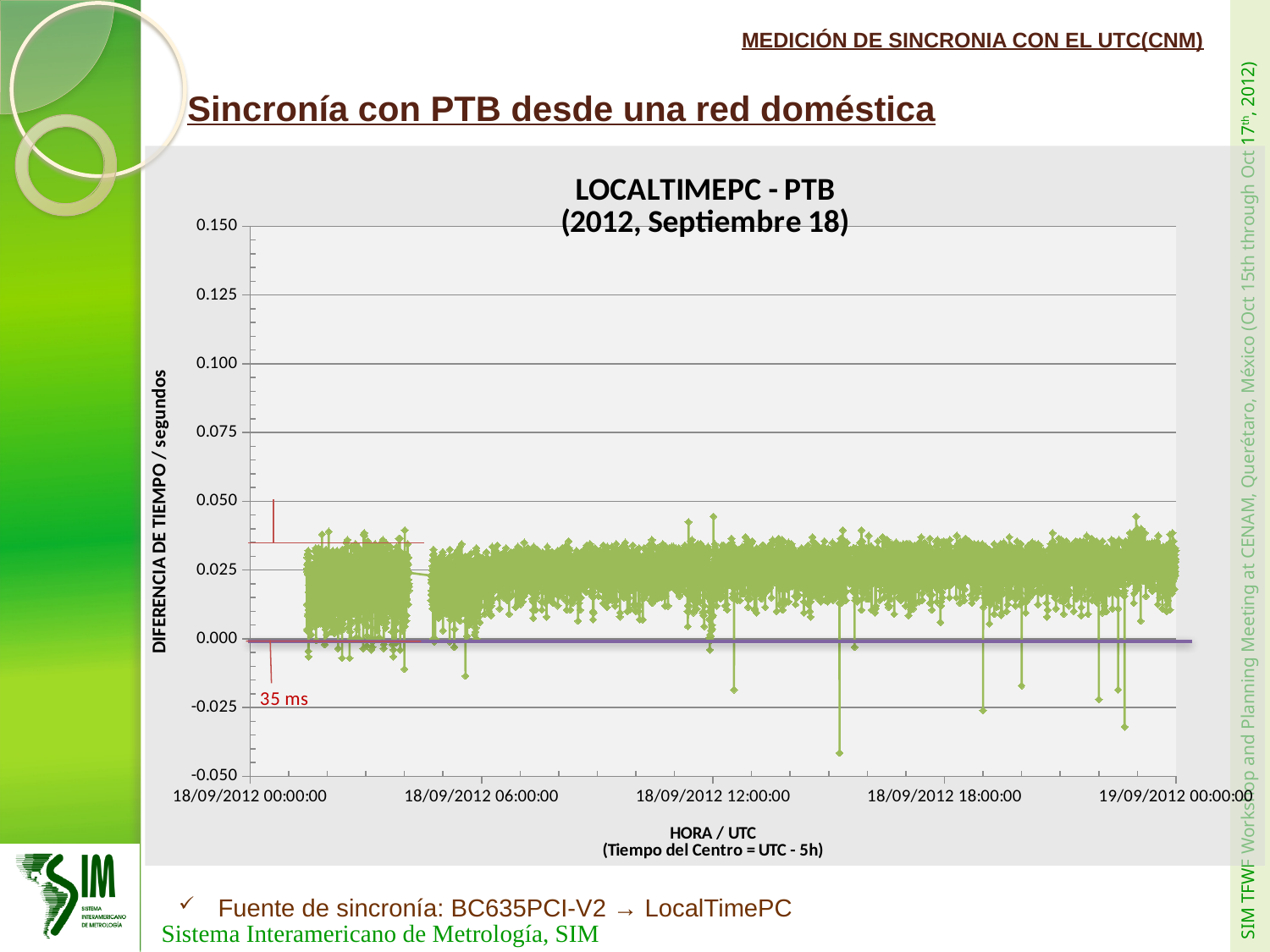
What is the last date and time label on the horizontal axis of the chart? 19/09/2012 00:00:00 How many labelled tick marks are there on the horizontal axis of the chart? 5 What kind of chart is shown on the slide? scatter chart What is the lowest value shown on the vertical axis of the chart? -0.050 What is the label of the vertical axis of the chart? DIFERENCIA DE TIEMPO / segundos Do the plotted time-difference values show a clear rising or falling trend across the day, or do they stay roughly level? roughly level What is the highest value shown on the vertical axis of the chart? 0.150 What value does the red annotation on the chart indicate for the spread of the data? 35 ms What is the title of the chart? LOCALTIMEPC - PTB (2012, Septiembre 18) What is the first date and time label on the horizontal axis of the chart? 18/09/2012 00:00:00 Is the lowest plotted point on the chart (the spike near 18/09/2012 16:00) greater or less than -0.025 seconds? less Are the bulk of the plotted time-difference values greater or less than 0.050 seconds? less